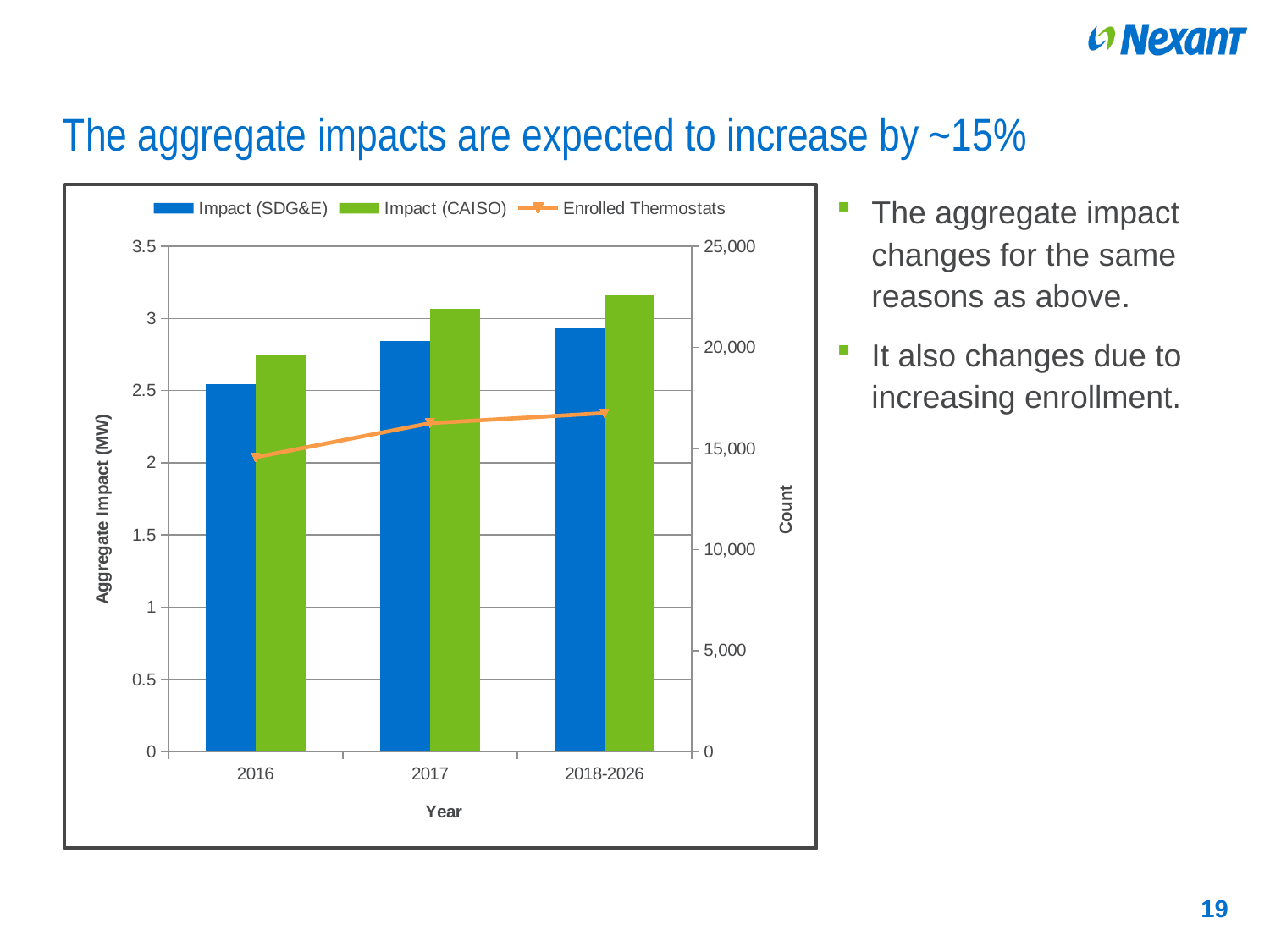
What is the title of the left vertical axis? Aggregate Impact (MW) Is the Impact (CAISO) value for 2018-2026 greater or less than 3? greater Which year category has the lowest Impact (SDG&E) bar? 2016 Which year category has the highest Impact (CAISO) bar? 2018-2026 Is the Enrolled Thermostats value for 2016 greater or less than 15,000? less What kind of chart is used for the Impact (SDG&E) and Impact (CAISO) series? Bar chart Is the Enrolled Thermostats value for 2018-2026 greater or less than 15,000? greater How many year categories are shown on the x axis? 3 Do the Enrolled Thermostats values rise or fall from 2016 to 2018-2026? rise How many series does the legend list? 3 In 2016, which is larger: Impact (SDG&E) or Impact (CAISO)? Impact (CAISO)